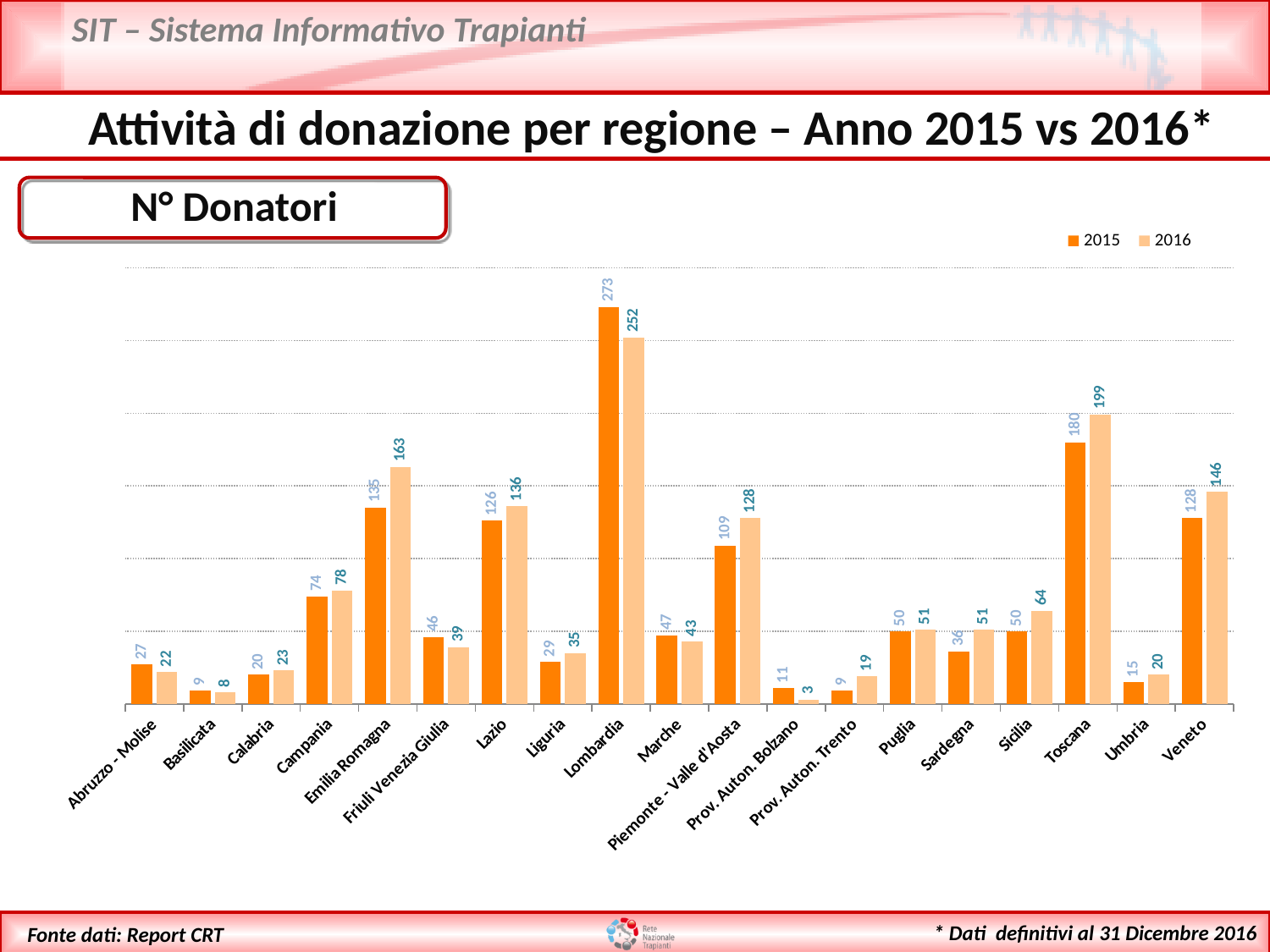
Which is larger for Lombardia, the 2015 value or the 2016 value? 2015 What is the difference between the 2016 and 2015 values for Emilia Romagna? 28 What is the 2016 value for Prov. Auton. Bolzano? 3 Which region has the lowest number of donors in 2016? Prov. Auton. Bolzano What is the number of donors for Toscana in 2016? 199 How many series does the legend list? 2 How many regions are shown on the x axis? 19 What is the title shown in the box above the chart? N° Donatori Which region has the highest number of donors in 2016? Lombardia What type of chart is shown on the slide? bar chart What is the number of donors for Lombardia in 2015? 273 What is the difference between the 2015 and 2016 values for Lombardia? 21